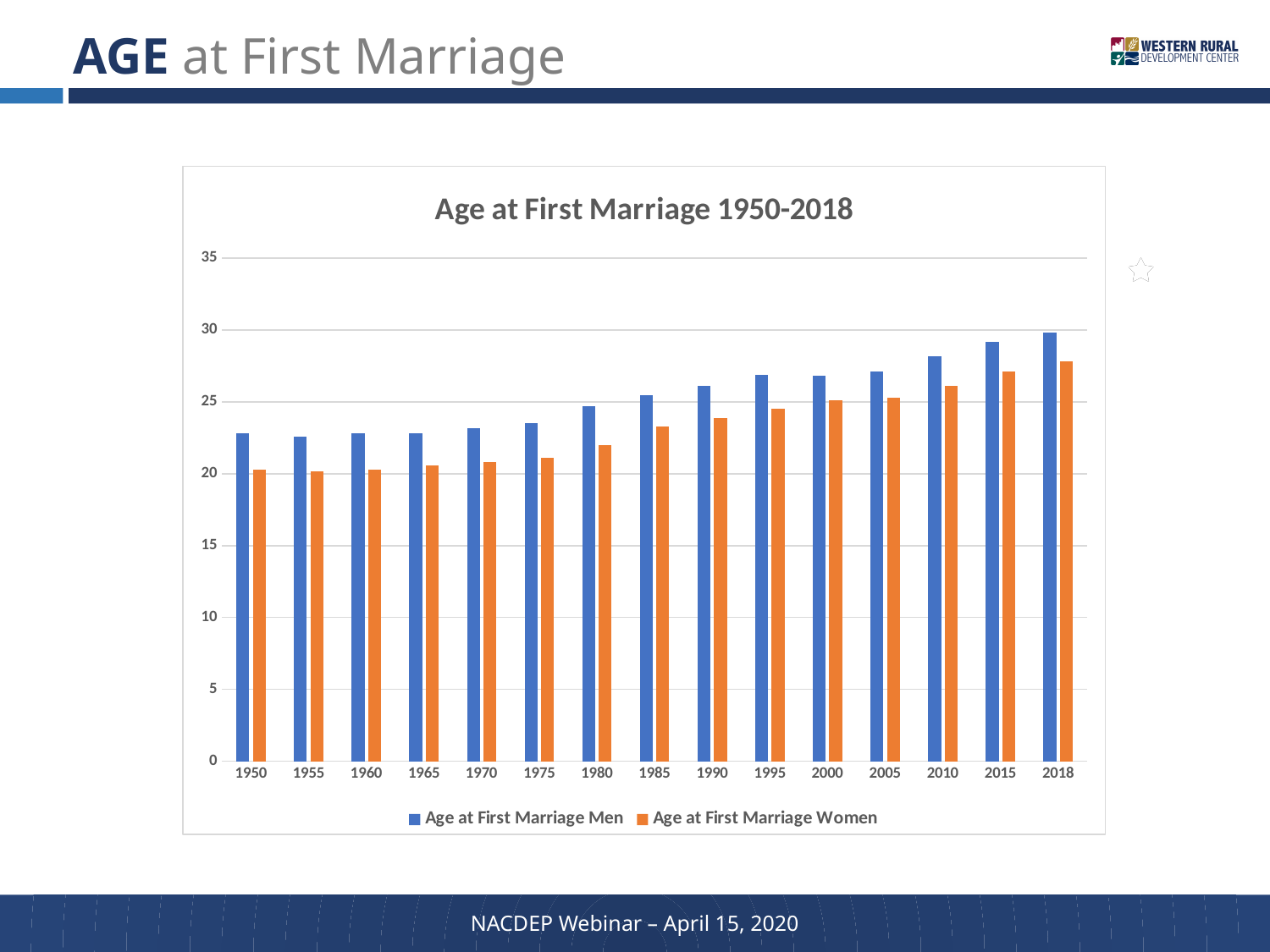
Is the age at first marriage for men in 2018 greater or less than 30? less In which year is the age at first marriage for men highest? 2018 In 2000, which is larger: the age at first marriage for men or for women? men Does the age at first marriage for men generally rise or fall from 1950 to 2018? rise Is the age at first marriage for women in 1990 greater or less than 25? less How many years are shown along the x axis? 15 In which year is the age at first marriage for women highest? 2018 What is the title of the chart? Age at First Marriage 1950-2018 What kind of chart is shown on the slide? bar chart How many series does the legend list? 2 Is the age at first marriage for women in 2018 greater or less than 25? greater